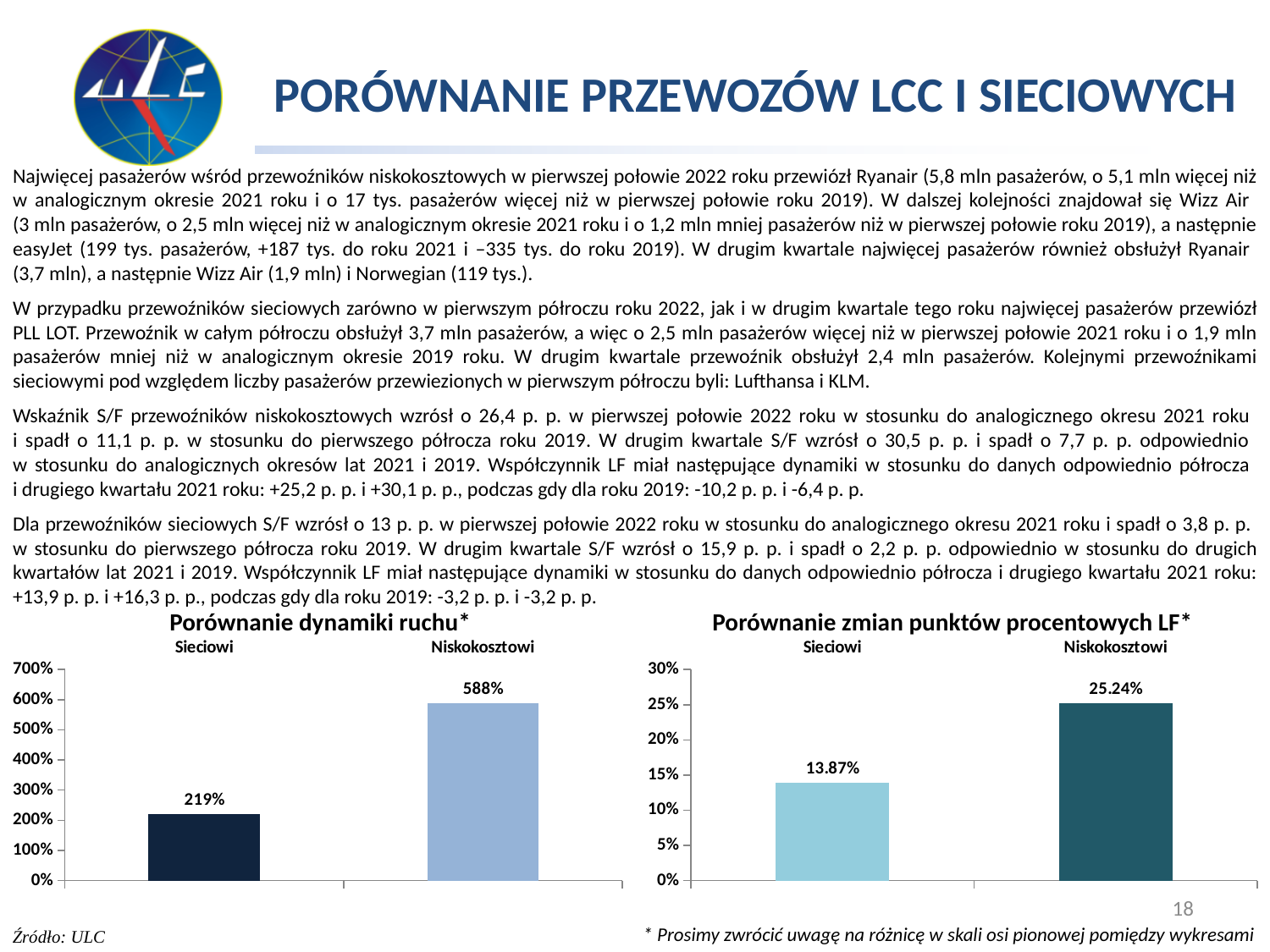
In the chart 'Porównanie dynamiki ruchu*', what is the value for Sieciowi? 219% What type of chart is 'Porównanie zmian punktów procentowych LF*'? bar chart In the chart 'Porównanie dynamiki ruchu*', what is the value for Niskokosztowi? 588% In the chart 'Porównanie zmian punktów procentowych LF*', what is the value for Sieciowi? 13.87% In the chart 'Porównanie dynamiki ruchu*', which category has the highest value? Niskokosztowi In the chart 'Porównanie zmian punktów procentowych LF*', what is the difference between the values for Niskokosztowi and Sieciowi? 11.37% In the chart 'Porównanie dynamiki ruchu*', what is the difference between the values for Niskokosztowi and Sieciowi? 369% In the chart 'Porównanie zmian punktów procentowych LF*', what is the value for Niskokosztowi? 25.24% How many bars are shown in the chart 'Porównanie dynamiki ruchu*'? 2 In the chart 'Porównanie zmian punktów procentowych LF*', which is larger: the value for Sieciowi or for Niskokosztowi? Niskokosztowi In the chart 'Porównanie zmian punktów procentowych LF*', which category has the lowest value? Sieciowi In the chart 'Porównanie dynamiki ruchu*', is the value for Sieciowi greater or less than 300%? less